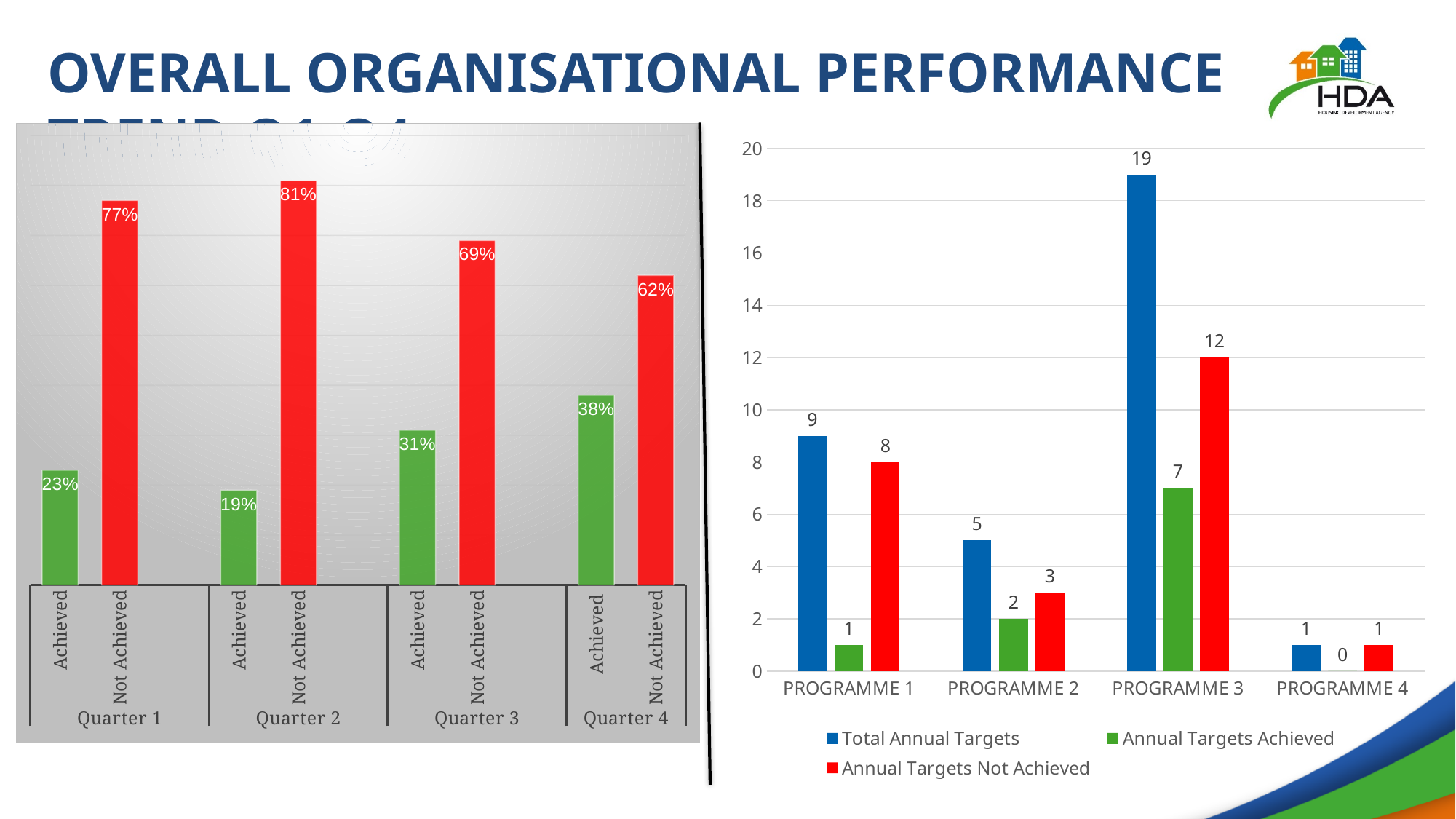
In the left chart, which quarter has the lowest Achieved percentage? Quarter 2 What kind of chart is the right chart? bar chart In the left chart, what percentage was not achieved in Quarter 2? 81% How many series does the legend of the right chart list? 3 In the left chart, which quarter has the highest Achieved percentage? Quarter 4 In the right chart, what is the value of Total Annual Targets for PROGRAMME 3? 19 In the left chart, does the Achieved percentage rise or fall from Quarter 2 to Quarter 4? rise In the right chart, what is the difference between Total Annual Targets and Annual Targets Not Achieved for PROGRAMME 1? 1 In the right chart, which programme has the highest Total Annual Targets? PROGRAMME 3 In the left chart, what is the difference between the Not Achieved and Achieved percentages in Quarter 3? 38% In the left chart, what percentage was achieved in Quarter 1? 23% In the right chart, what is the value of Annual Targets Achieved for PROGRAMME 4? 0